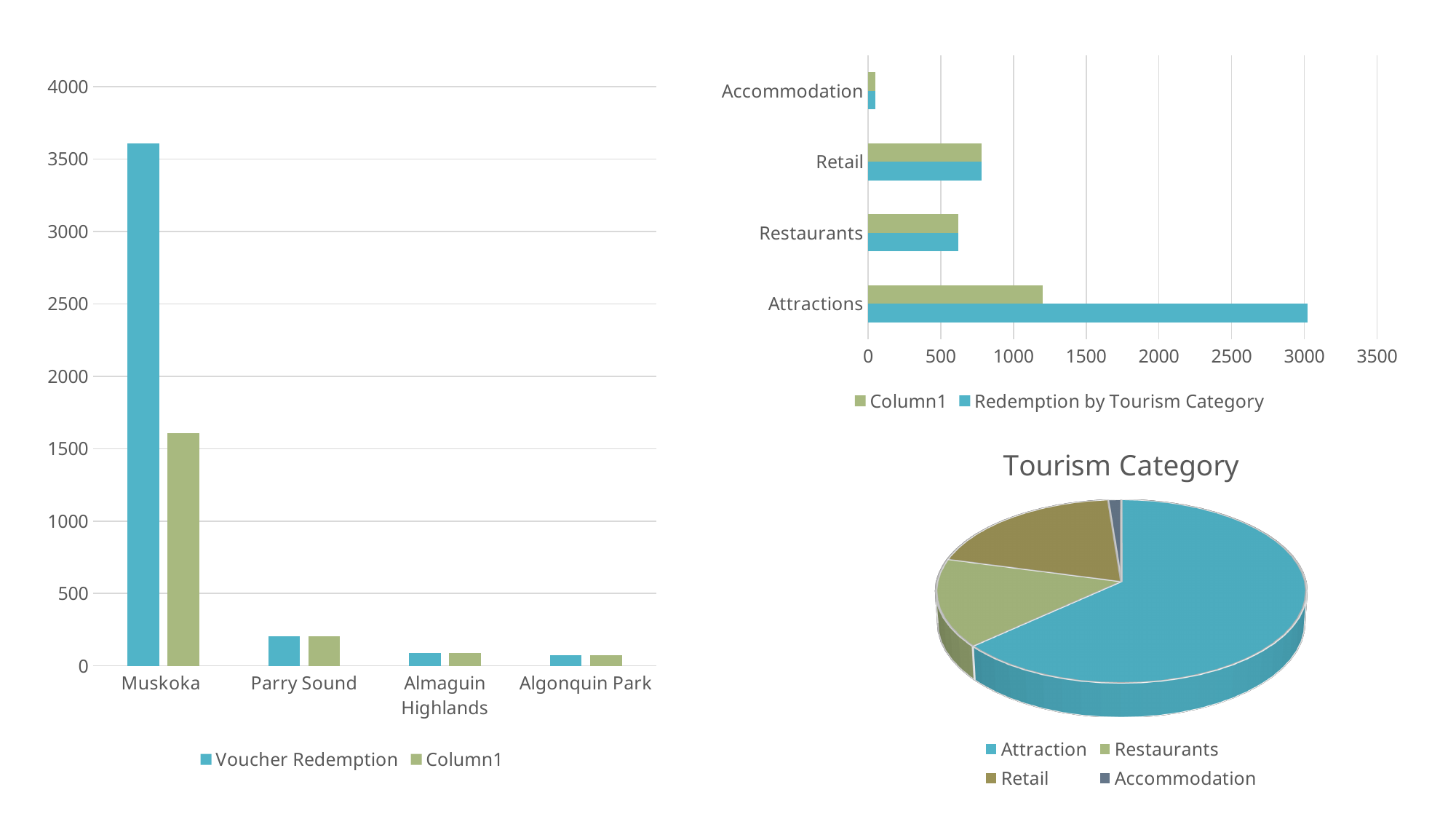
In the top-right horizontal bar chart, is the Redemption by Tourism Category value for Attractions greater or less than 2500? greater In the left bar chart, which category has the highest Voucher Redemption value? Muskoka In the left bar chart, is the Column1 value for Muskoka greater or less than 1500? greater In the pie chart titled 'Tourism Category', which slice is the largest? Attraction In the left bar chart, is the Voucher Redemption value for Parry Sound greater or less than 500? less In the top-right horizontal bar chart, which category has the lowest Redemption by Tourism Category value? Accommodation In the top-right horizontal bar chart, which category has the highest Redemption by Tourism Category value? Attractions How many categories are shown on the x axis of the left bar chart? 4 What kind of chart is the chart on the left side of the slide? bar chart How many series does the legend of the left bar chart list? 2